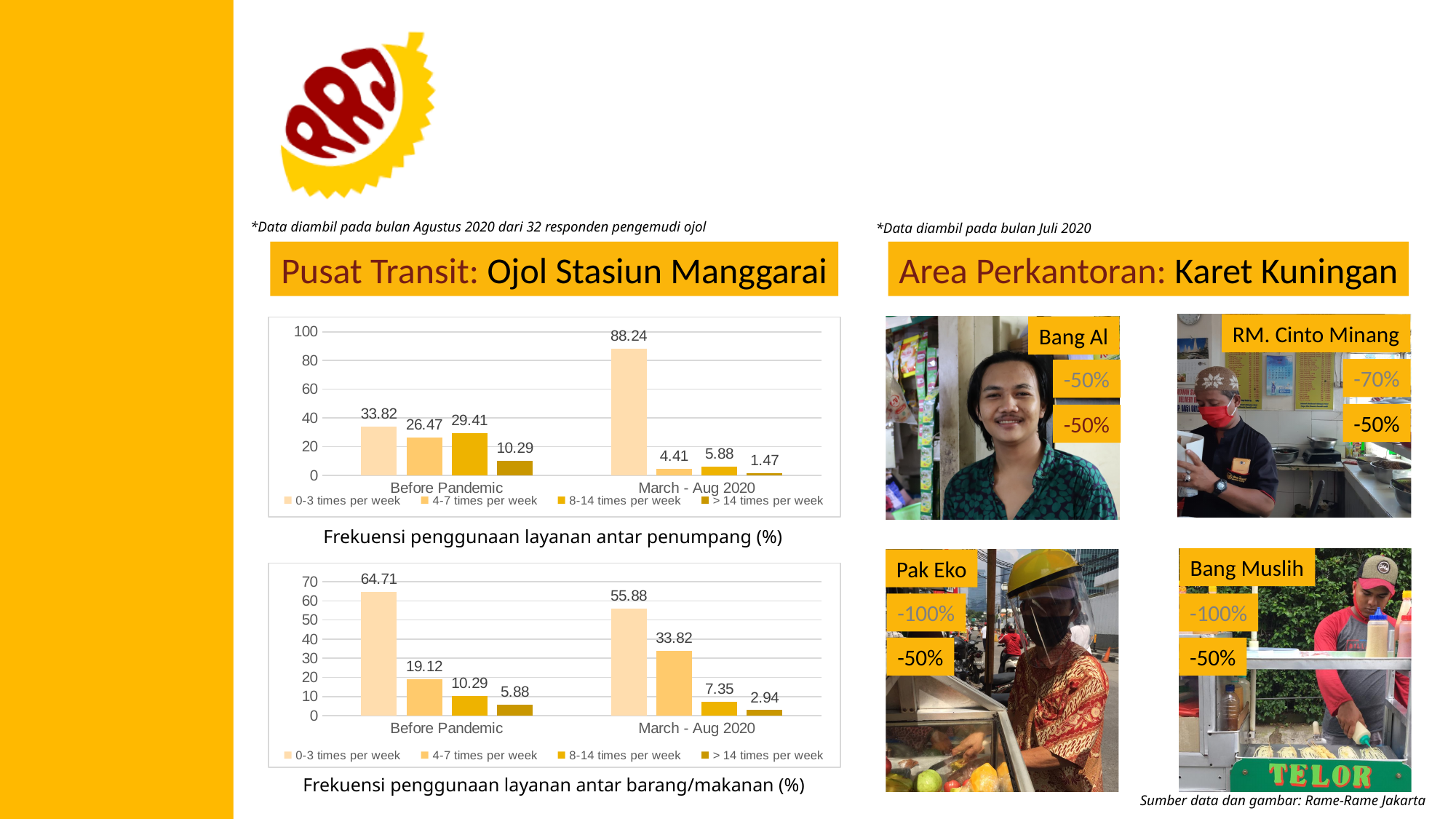
In the top chart (Frekuensi penggunaan layanan antar penumpang), what is the value for > 14 times per week before the pandemic? 10.29 How many categories are shown on the x axis of the top chart (Frekuensi penggunaan layanan antar penumpang)? 2 In the top chart (Frekuensi penggunaan layanan antar penumpang), which is larger before the pandemic: 4-7 times per week or 8-14 times per week? 8-14 times per week In the bottom chart (Frekuensi penggunaan layanan antar barang/makanan), does the value for 0-3 times per week rise or fall from Before Pandemic to March - Aug 2020? Fall In the top chart (Frekuensi penggunaan layanan antar penumpang), which series has the lowest value in March - Aug 2020? > 14 times per week In the top chart (Frekuensi penggunaan layanan antar penumpang), what is the value for 0-3 times per week in March - Aug 2020? 88.24 How many series does the legend of the bottom chart (Frekuensi penggunaan layanan antar barang/makanan) list? 4 In the bottom chart (Frekuensi penggunaan layanan antar barang/makanan), what is the difference between the 4-7 times per week values for March - Aug 2020 and Before Pandemic? 14.7 In the bottom chart (Frekuensi penggunaan layanan antar barang/makanan), what is the value for 4-7 times per week in March - Aug 2020? 33.82 What kind of chart is the bottom chart (Frekuensi penggunaan layanan antar barang/makanan)? Bar chart In the top chart (Frekuensi penggunaan layanan antar penumpang), what is the difference between the 0-3 times per week values for March - Aug 2020 and Before Pandemic? 54.42 In the bottom chart (Frekuensi penggunaan layanan antar barang/makanan), which series has the highest value before the pandemic? 0-3 times per week